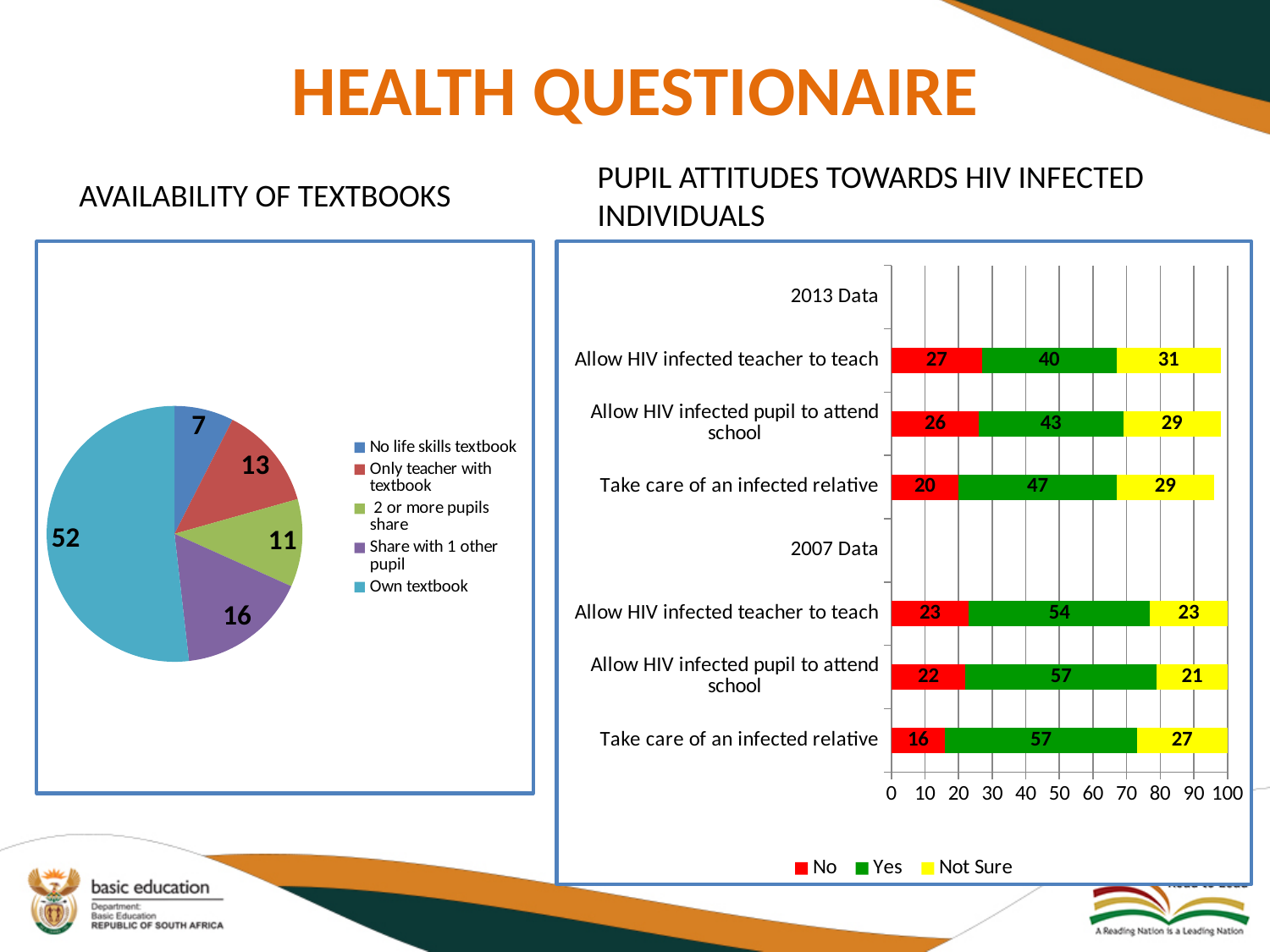
What type of chart is the Availability of Textbooks chart? Pie chart In the Pupil Attitudes Towards HIV Infected Individuals chart, what colour represents the Not Sure series? Yellow In the Pupil Attitudes Towards HIV Infected Individuals chart, what is the Yes value for Allow HIV infected teacher to teach in the 2013 data? 40 In the Pupil Attitudes Towards HIV Infected Individuals chart, what is the No value for Take care of an infected relative in the 2007 data? 16 In the Pupil Attitudes Towards HIV Infected Individuals chart, which is larger: the Yes value for Allow HIV infected teacher to teach in 2007 or in 2013? 2007 In the Pupil Attitudes Towards HIV Infected Individuals chart, what is the difference between the Not Sure values for Allow HIV infected teacher to teach in 2013 and 2007? 8 How many categories does the Availability of Textbooks pie chart show? 5 In the Availability of Textbooks pie chart, which category has the smallest value? No life skills textbook In the Pupil Attitudes Towards HIV Infected Individuals chart, what is the total of the stacked bar for Allow HIV infected pupil to attend school in the 2007 data? 100 In the Availability of Textbooks pie chart, what value is shown for Own textbook? 52 How many series does the legend of the Pupil Attitudes Towards HIV Infected Individuals chart list? 3 In the Availability of Textbooks pie chart, what is the difference between Share with 1 other pupil and 2 or more pupils share? 5